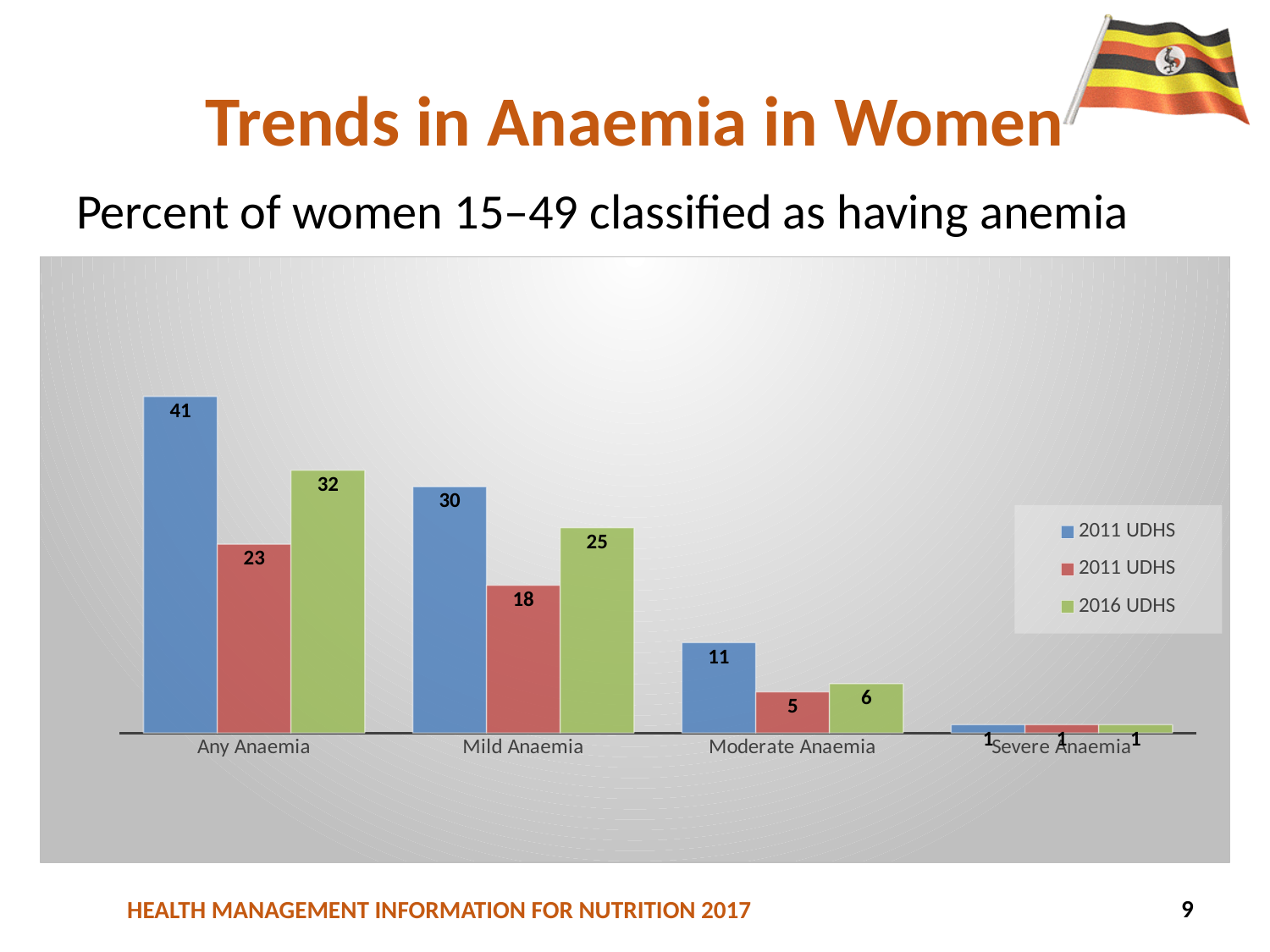
For Moderate Anaemia, which is larger: the red bar or the green bar? the green bar Which category has the highest 2016 UDHS value? Any Anaemia How many anaemia categories are shown on the x axis? 4 What is the difference between the 2016 UDHS values for Any Anaemia and Mild Anaemia? 7 Which category has the lowest 2016 UDHS value? Severe Anaemia What kind of chart is shown on the slide? bar chart Do the 2016 UDHS values rise or fall from Any Anaemia to Severe Anaemia? fall What value does the red bar show for Mild Anaemia? 18 What is the 2016 UDHS value for Any Anaemia? 32 What value does the blue bar show for Moderate Anaemia? 11 How many series does the legend list? 3 What is the 2016 UDHS value for Mild Anaemia? 25